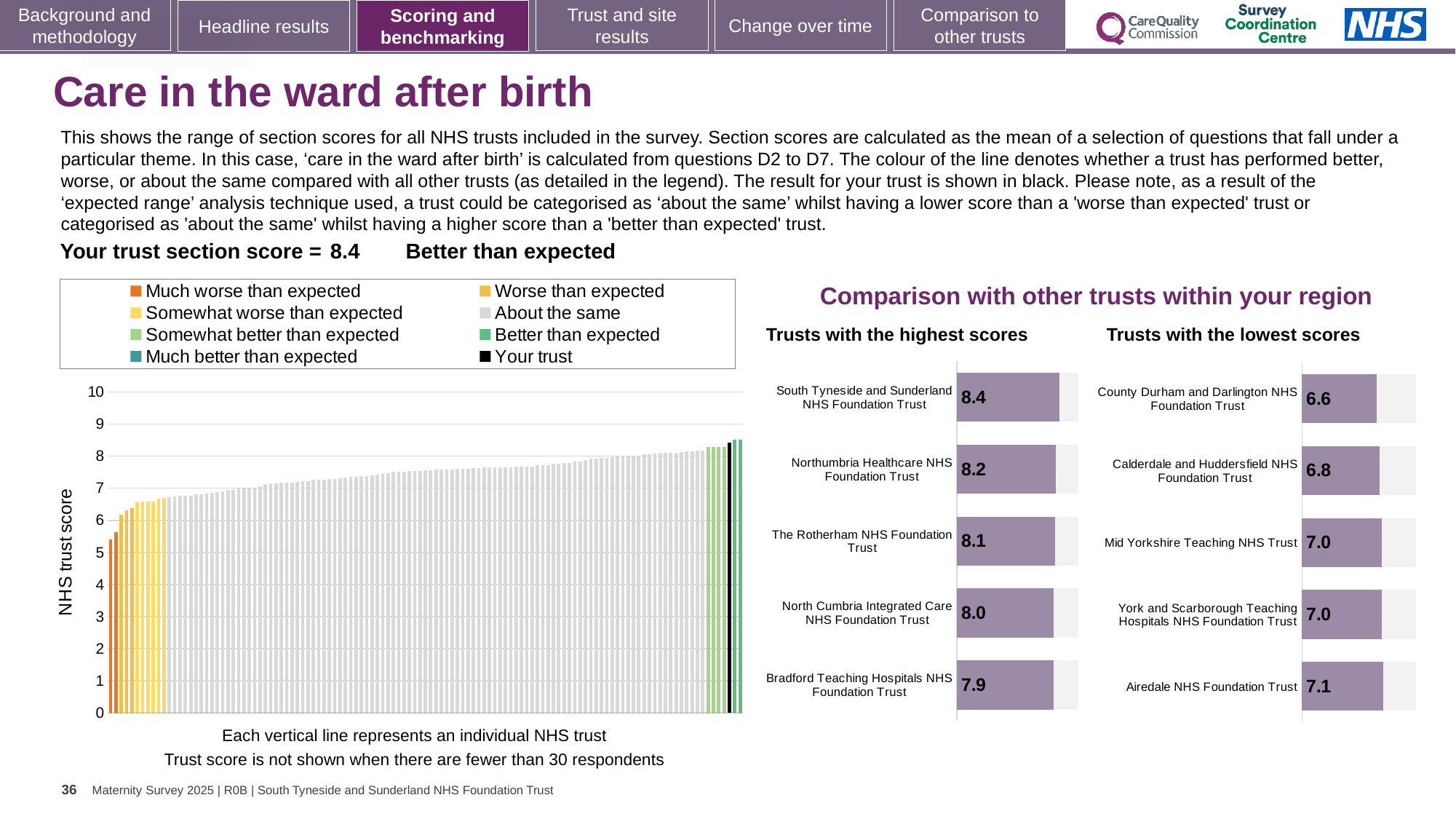
In the 'Trusts with the lowest scores' chart, which has the larger score: Calderdale and Huddersfield NHS Foundation Trust or Airedale NHS Foundation Trust? Airedale NHS Foundation Trust In the 'Trusts with the lowest scores' chart, which trust has the lowest score? County Durham and Darlington NHS Foundation Trust In the 'Trusts with the highest scores' chart, what is the score for Northumbria Healthcare NHS Foundation Trust? 8.2 In the 'Trusts with the lowest scores' chart, what is the score for Calderdale and Huddersfield NHS Foundation Trust? 6.8 In the 'Trusts with the highest scores' chart, which trust has the highest score? South Tyneside and Sunderland NHS Foundation Trust In the 'Trusts with the lowest scores' chart, what is the difference between the scores of Airedale NHS Foundation Trust and County Durham and Darlington NHS Foundation Trust? 0.5 How many trusts are shown in the 'Trusts with the highest scores' chart? 5 In the 'Trusts with the highest scores' chart, what is the difference between the scores of South Tyneside and Sunderland NHS Foundation Trust and Bradford Teaching Hospitals NHS Foundation Trust? 0.5 What kind of chart is the large chart on the left showing NHS trust scores? Bar chart In the large chart on the left, is the value of the leftmost (lowest) bar greater or less than 6? less In the large chart on the left, do the trust scores rise or fall from left to right? Rise How many entries does the legend of the large chart on the left list? 8